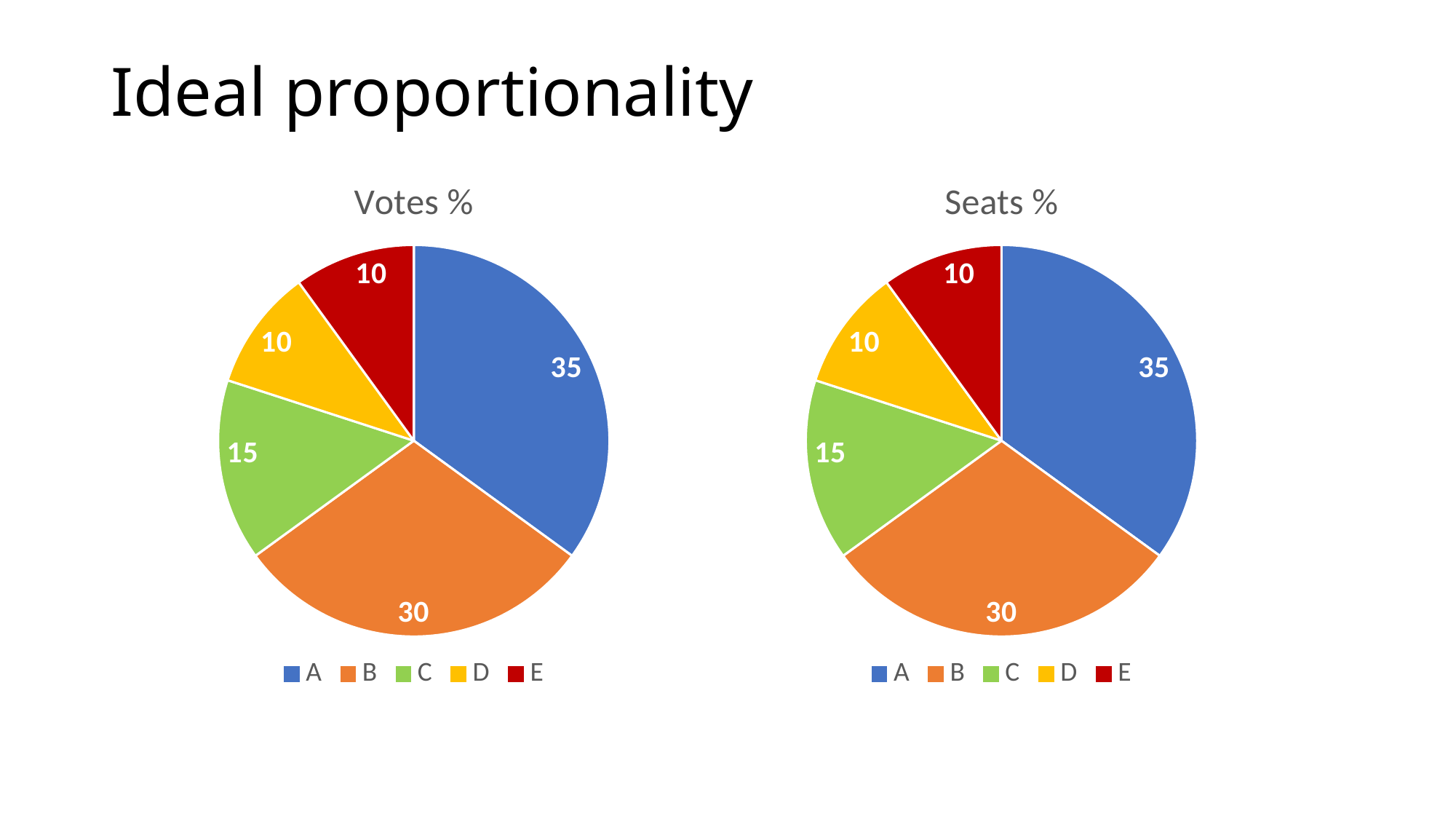
What is the title of the chart on the right of the slide? Seats % In the 'Votes %' chart, what is the value for A? 35 In the 'Votes %' chart, which is larger, the value for C or the value for D? C What kind of chart is the 'Seats %' chart? pie chart In the 'Votes %' chart, what is the value for C? 15 How many entries does the legend of the 'Seats %' chart list? 5 In the 'Seats %' chart, what is the value for B? 30 In the 'Votes %' chart, what share of the pie does slice B represent? 30% In the 'Seats %' chart, which category has the largest slice? A In the 'Seats %' chart, what is the difference between the values for B and C? 15 In the 'Votes %' chart, what is the difference between the values for A and B? 5 How many slices does the 'Votes %' chart have? 5